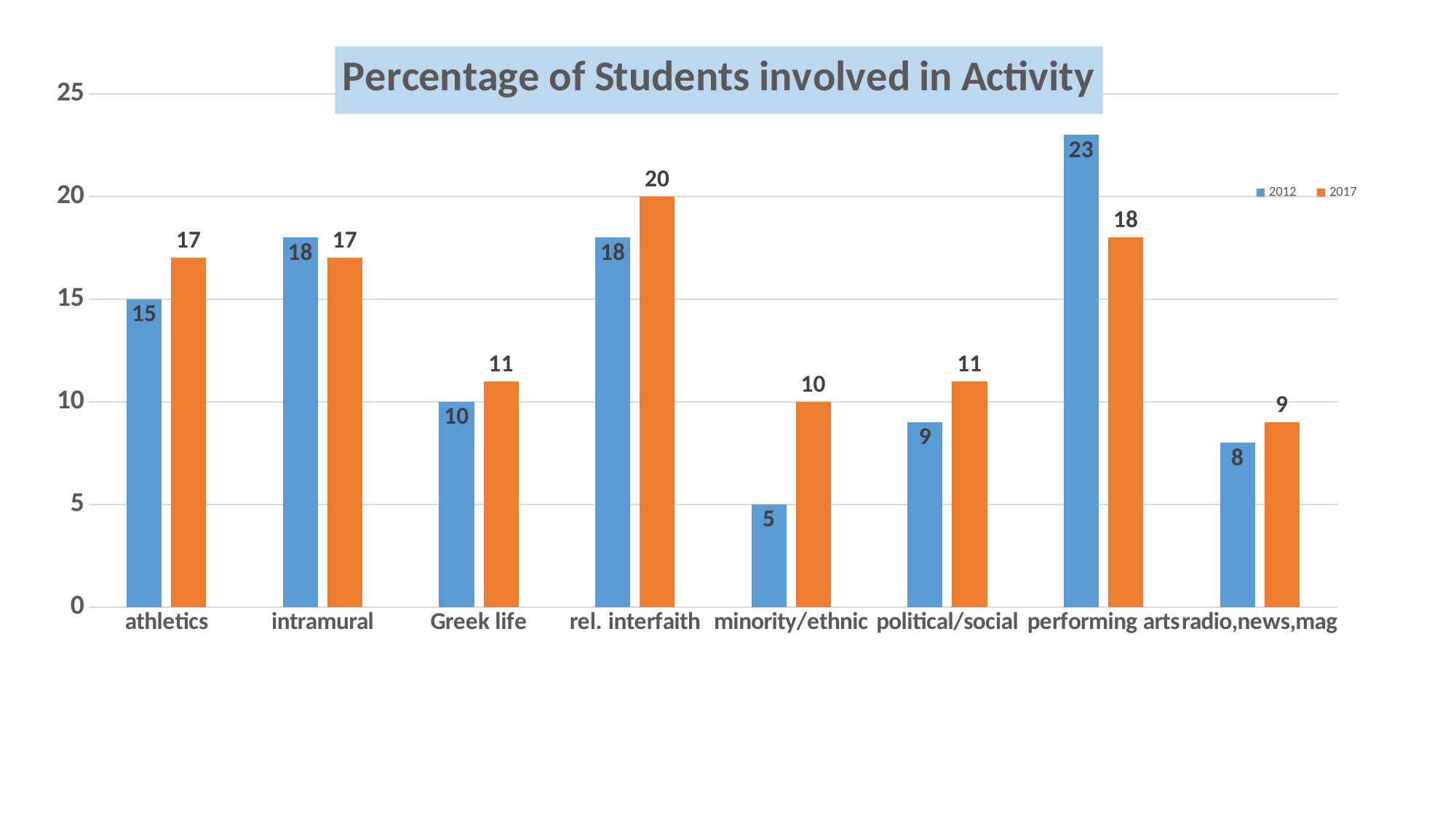
How many series does the legend list? 2 Which category has the highest 2012 value? performing arts Which category has the lowest 2017 value? radio,news,mag What kind of chart is this? bar chart Which is larger for intramural, the 2012 value or the 2017 value? 2012 What is the title of the chart? Percentage of Students involved in Activity What is the 2017 value for rel. interfaith? 20 What is the 2012 value for performing arts? 23 Which colour represents the 2017 series? orange How many categories are shown on the x axis? 8 What is the difference between the 2017 and 2012 values for minority/ethnic? 5 What is the 2012 value for minority/ethnic? 5